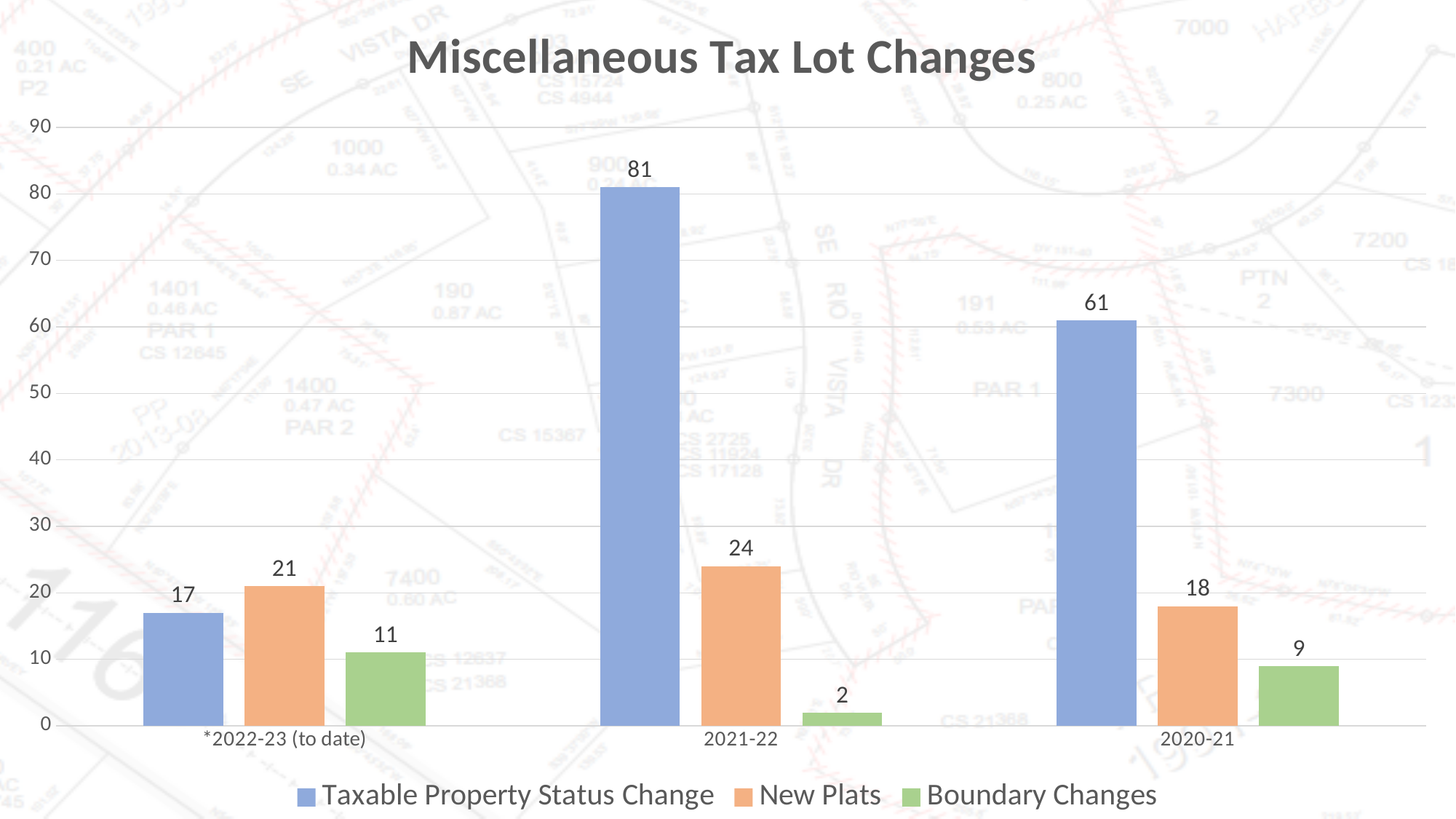
How many year categories are shown on the x axis? 3 What is the value for Boundary Changes in *2022-23 (to date)? 11 How many series does the legend list? 3 What is the value for New Plats in 2020-21? 18 Which year has the lowest value for Boundary Changes? 2021-22 Which year has the highest value for Taxable Property Status Change? 2021-22 What kind of chart is shown on the slide? bar chart What is the title of the chart? Miscellaneous Tax Lot Changes Is the value for Taxable Property Status Change in 2020-21 greater or less than 50? greater Which is larger in *2022-23 (to date): Taxable Property Status Change or New Plats? New Plats What is the difference between Taxable Property Status Change in 2021-22 and in 2020-21? 20 What is the value for Taxable Property Status Change in 2021-22? 81